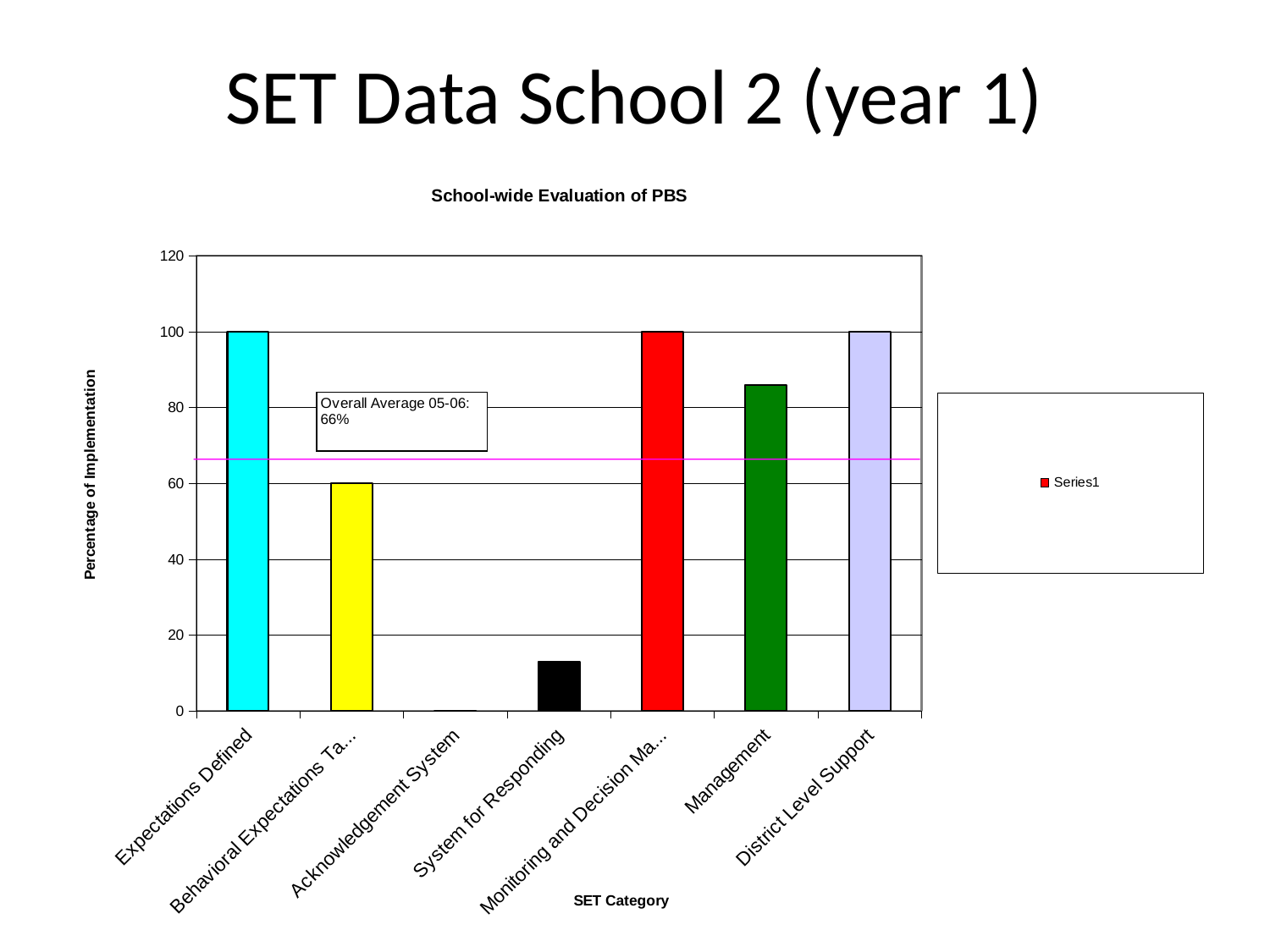
What is the percentage of implementation for Expectations Defined? 100 What is the title of the chart? School-wide Evaluation of PBS Which has a higher percentage of implementation, Management or System for Responding? Management Is the value for Management greater or less than 80? greater How many SET categories are shown on the x axis? 7 What is the percentage of implementation for Acknowledgement System? 0 What overall average for 05-06 is noted on the chart? 66% What type of chart is shown on the slide? bar chart Which SET category has the lowest percentage of implementation? Acknowledgement System What is the percentage of implementation for District Level Support? 100 How many series does the legend list? 1 Is the value for System for Responding greater or less than 20? less